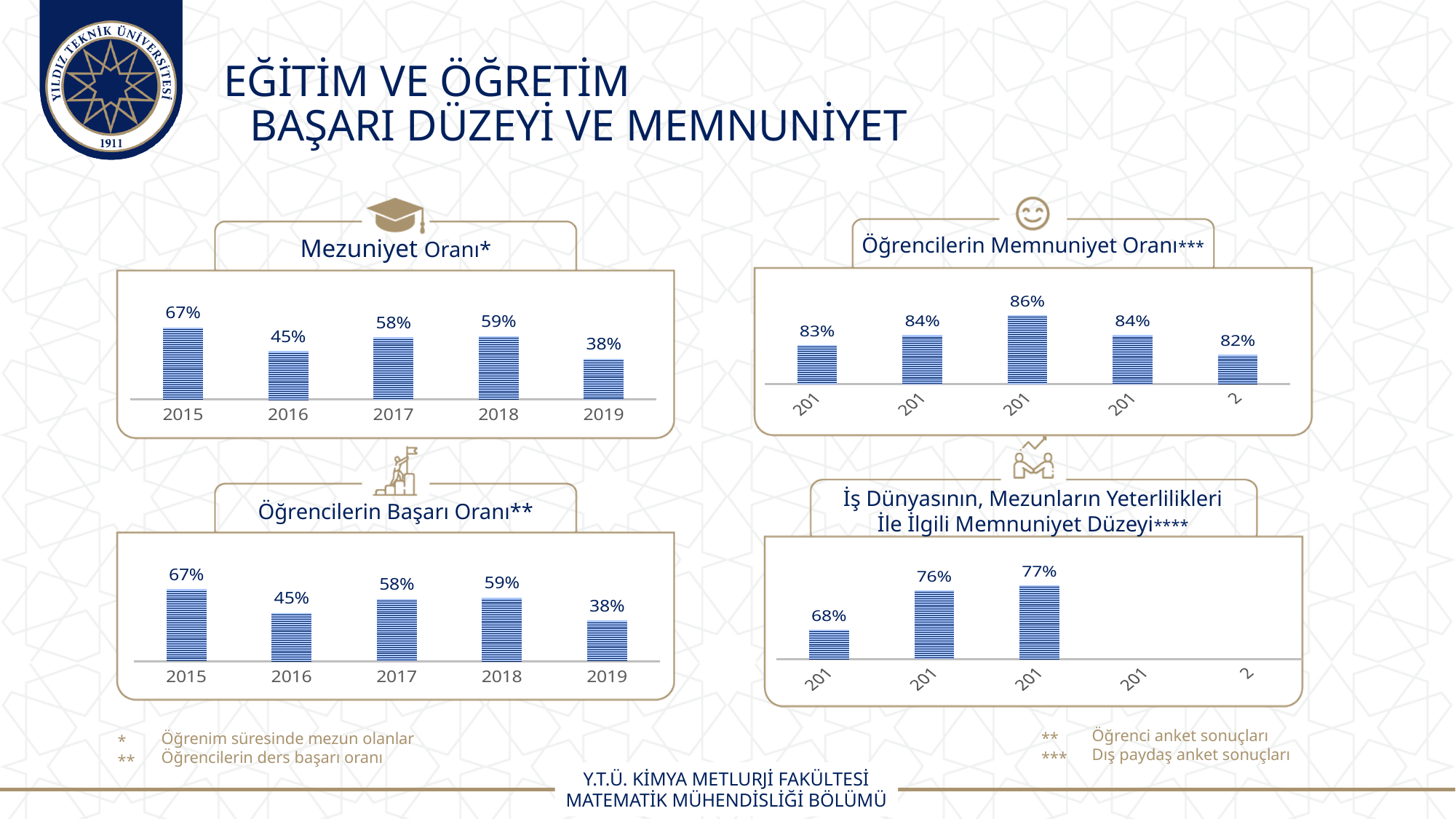
In the Öğrencilerin Başarı Oranı chart, which is larger, the value for 2017 or the value for 2018? 2018 How many years are shown in the Öğrencilerin Başarı Oranı chart? 5 What kind of chart is the Mezuniyet Oranı chart? Bar chart In the Mezuniyet Oranı chart, which year has the highest value? 2015 In the Öğrencilerin Memnuniyet Oranı chart, what is the highest value shown? 86% In the Öğrencilerin Başarı Oranı chart, what is the value for 2017? 58% In the Mezuniyet Oranı chart, what is the value for 2016? 45% In the İş Dünyasının, Mezunların Yeterlilikleri İle İlgili Memnuniyet Düzeyi chart, what is the highest value shown? 77% In the Öğrencilerin Başarı Oranı chart, does the value rise or fall from 2015 to 2016? Fall In the Öğrencilerin Memnuniyet Oranı chart, what is the lowest value shown? 82% In the Mezuniyet Oranı chart, which year has the lowest value? 2019 In the Mezuniyet Oranı chart, what is the difference between the values for 2018 and 2019? 21 percentage points